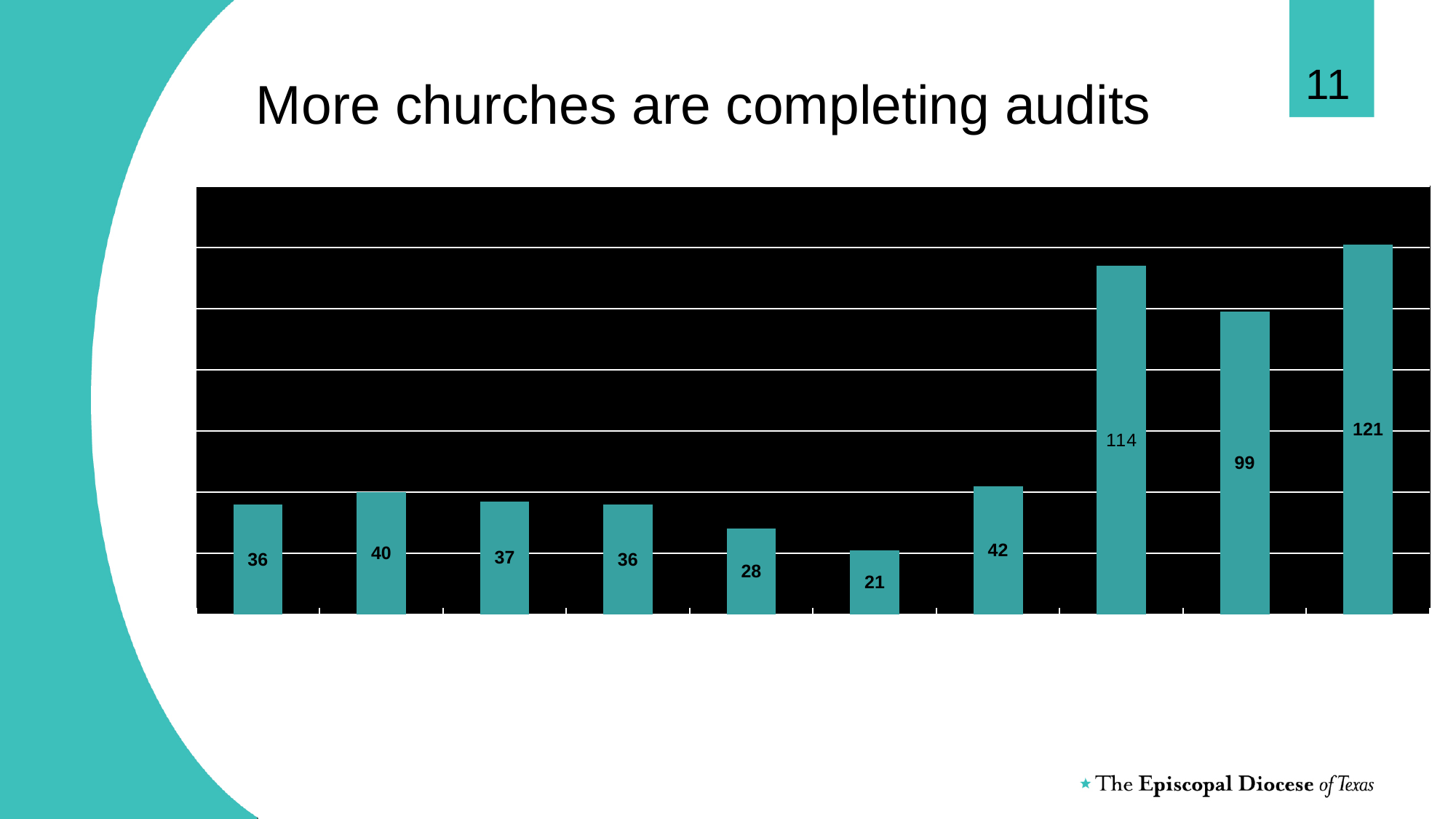
What is the difference between the value of the last bar and the value of the first bar? 85 What is the value shown on the eighth bar from the left? 114 Which is larger, the value of the eighth bar (114) or the ninth bar (99)? 114 What is the lowest value shown in the chart? 21 What is the highest value shown in the chart? 121 Do the values of the last three bars rise or fall compared with the first seven bars? rise What is the title of the slide containing the chart? More churches are completing audits What is the value shown on the last (rightmost) bar? 121 What is the value shown on the sixth bar from the left? 21 What is the value shown on the first (leftmost) bar? 36 What kind of chart is shown on the slide? bar chart How many bars are plotted in the chart? 10